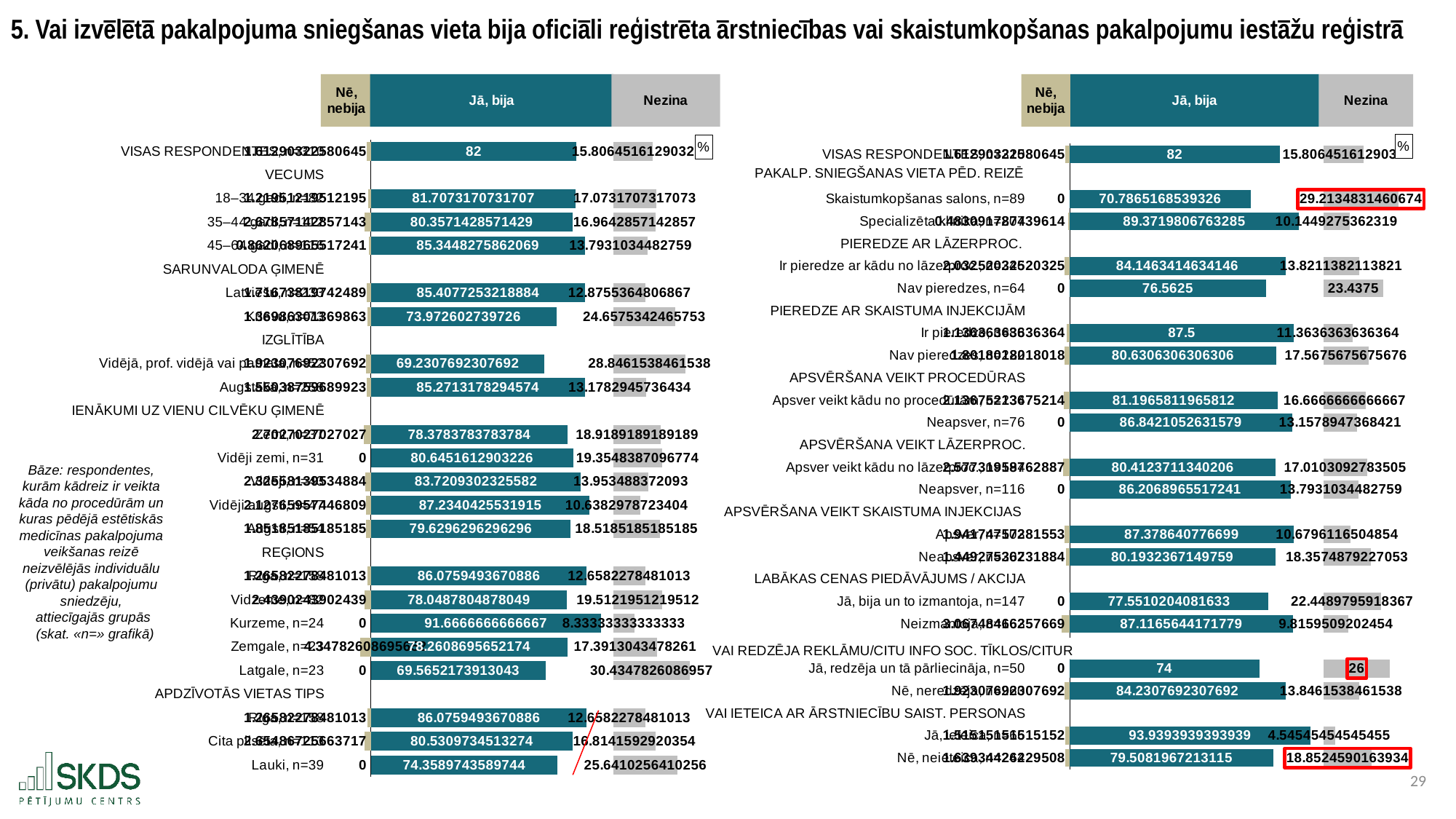
What type of chart is shown on the left side of the slide? Stacked bar chart In the left chart, what is the 'Nezina' value for Latgale, n=23? 30.4347826086957 In the right chart, which category has the lowest 'Jā, bija' value? Skaistumkopšanas salons, n=89 In the left chart, what is the 'Jā, bija' value for Kurzeme, n=24? 91.6666666666667 In the right chart, what is the 'Nezina' value for Skaistumkopšanas salons, n=89? 29.2134831460674 In the left chart, what is the 'Nē, nebija' value for Lauki, n=39? 0 In the right chart, what is the 'Nezina' value for Nav pieredzes, n=64 (pieredze ar lāzerproc.)? 23.4375 In the right chart, what is the 'Jā, bija' value for 'Jā, redzēja un tā pārliecināja, n=50'? 74 In the left chart, which region has the highest 'Jā, bija' value? Kurzeme, n=24 In the right chart, is the 'Jā, bija' value larger for Neapsver, n=76 or for 'Jā, bija un to izmantoja, n=147'? Neapsver, n=76 In the left chart, what is the 'Jā, bija' value for VISAS RESPONDENTES? 82